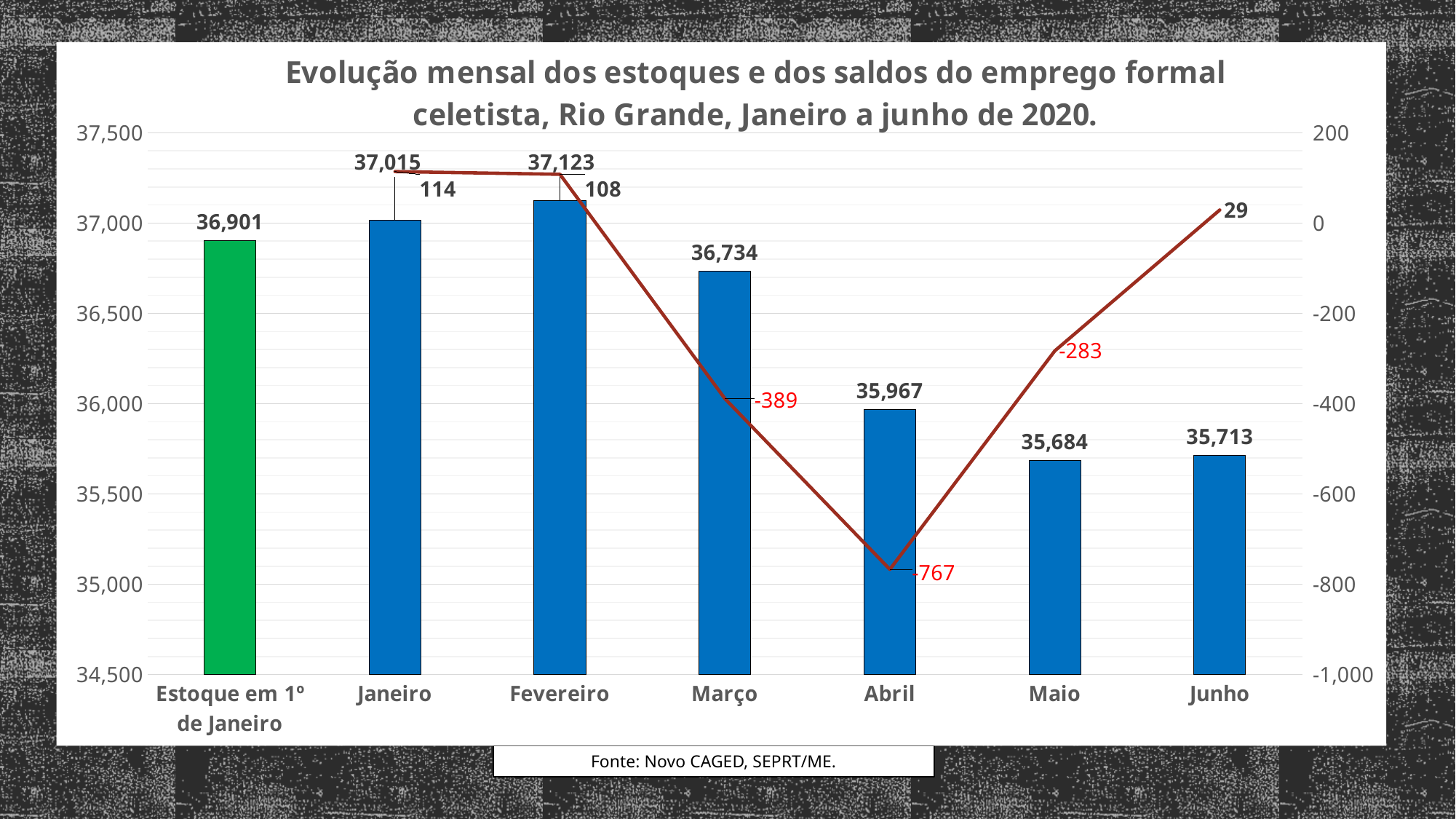
Which is larger, the stock bar for Maio or for Junho? Junho What is the difference between the stock bars for Fevereiro and Março? 389 Which month has the lowest stock bar? Maio Does the saldo line rise or fall from Fevereiro to Abril? Fall How many bars are plotted in the chart? 7 What is the source cited below the chart? Novo CAGED, SEPRT/ME. Which month has the highest stock bar? Fevereiro What is the bar value for Estoque em 1º de Janeiro? 36,901 What is the stock (bar) value for Fevereiro? 37,123 What is the saldo (line) value for Abril? -767 What kind of chart is shown on the slide? Combined bar and line chart Which month has the lowest saldo value on the line? Abril